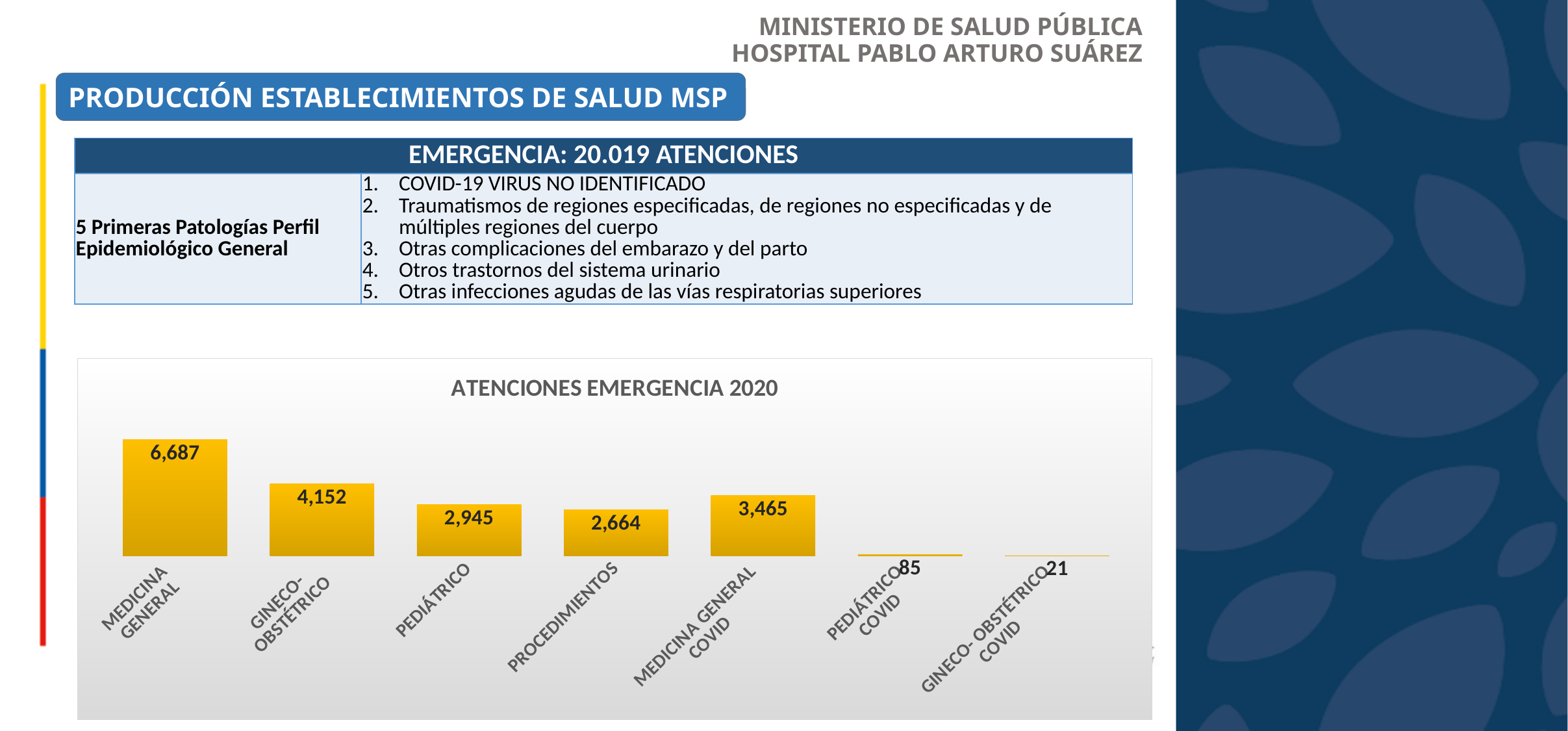
Which category has the lowest value in the ATENCIONES EMERGENCIA 2020 chart? GINECO-OBSTÉTRICO COVID What is the value for MEDICINA GENERAL in the ATENCIONES EMERGENCIA 2020 chart? 6,687 What is the value for MEDICINA GENERAL COVID in the ATENCIONES EMERGENCIA 2020 chart? 3,465 Which is larger in the ATENCIONES EMERGENCIA 2020 chart: MEDICINA GENERAL COVID or PEDIÁTRICO? MEDICINA GENERAL COVID What is the difference between the values for PEDIÁTRICO and PROCEDIMIENTOS in the ATENCIONES EMERGENCIA 2020 chart? 281 What is the value for GINECO-OBSTÉTRICO COVID in the ATENCIONES EMERGENCIA 2020 chart? 21 Which category has the highest value in the ATENCIONES EMERGENCIA 2020 chart? MEDICINA GENERAL What is the difference between the values for MEDICINA GENERAL and GINECO-OBSTÉTRICO in the ATENCIONES EMERGENCIA 2020 chart? 2,535 What kind of chart is the ATENCIONES EMERGENCIA 2020 chart? bar chart How many categories are shown in the ATENCIONES EMERGENCIA 2020 chart? 7 What is the value for GINECO-OBSTÉTRICO in the ATENCIONES EMERGENCIA 2020 chart? 4,152 What is the title of the chart on the slide? ATENCIONES EMERGENCIA 2020